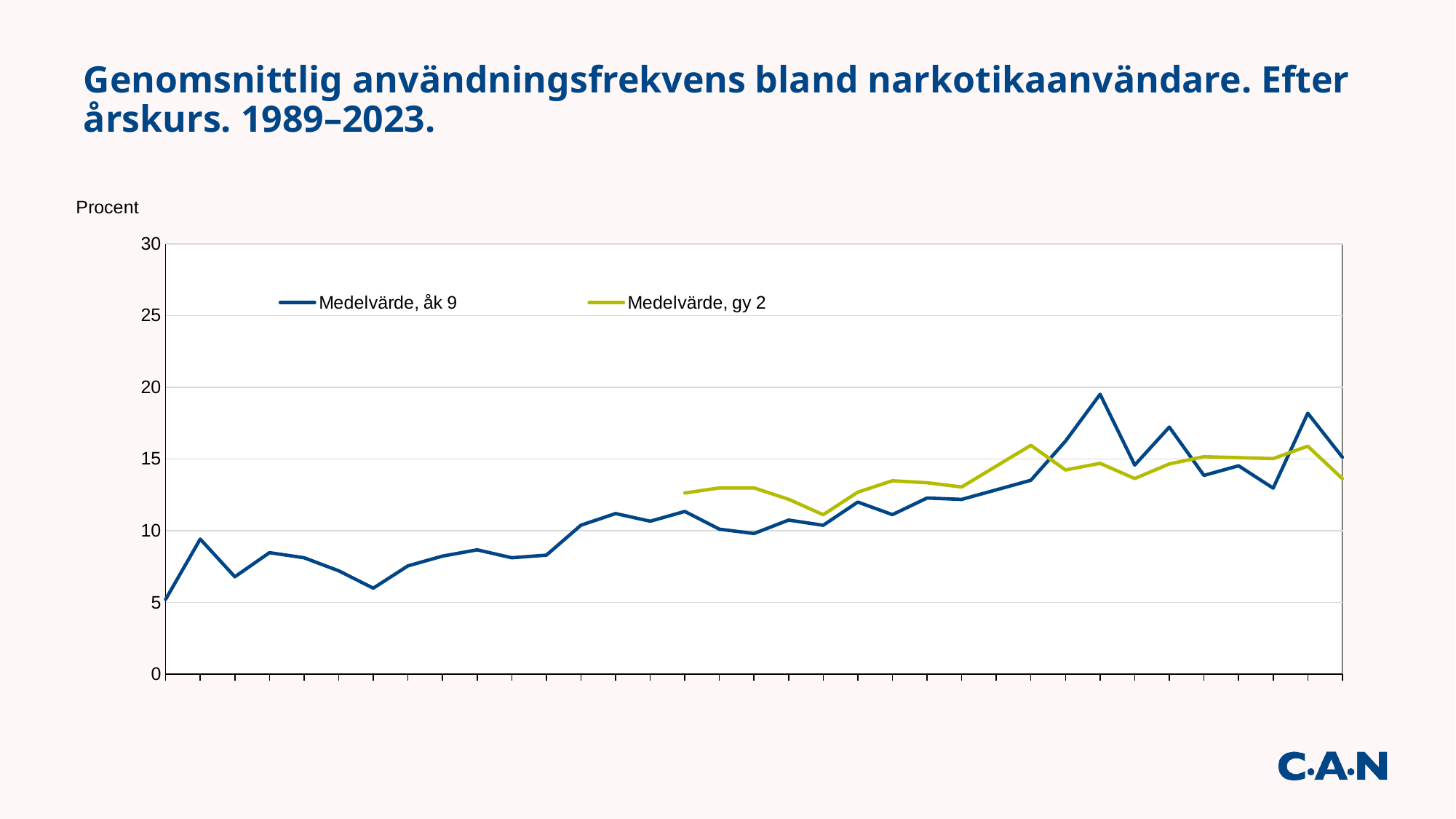
What is the label on the vertical axis? Procent Is the highest value of the Medelvärde, åk 9 series greater or less than 20? less Is the first value of the Medelvärde, åk 9 series greater or less than 10? less Is the last value of the Medelvärde, åk 9 series greater or less than 10? greater What are the two series named in the legend? Medelvärde, åk 9 and Medelvärde, gy 2 Which series starts later along the x axis, Medelvärde, åk 9 or Medelvärde, gy 2? Medelvärde, gy 2 Does the Medelvärde, åk 9 series overall rise or fall from the start to the end of the period? rise Which series reaches the higher peak value, Medelvärde, åk 9 or Medelvärde, gy 2? Medelvärde, åk 9 How many series does the legend list? 2 What kind of chart is shown on the slide? line chart